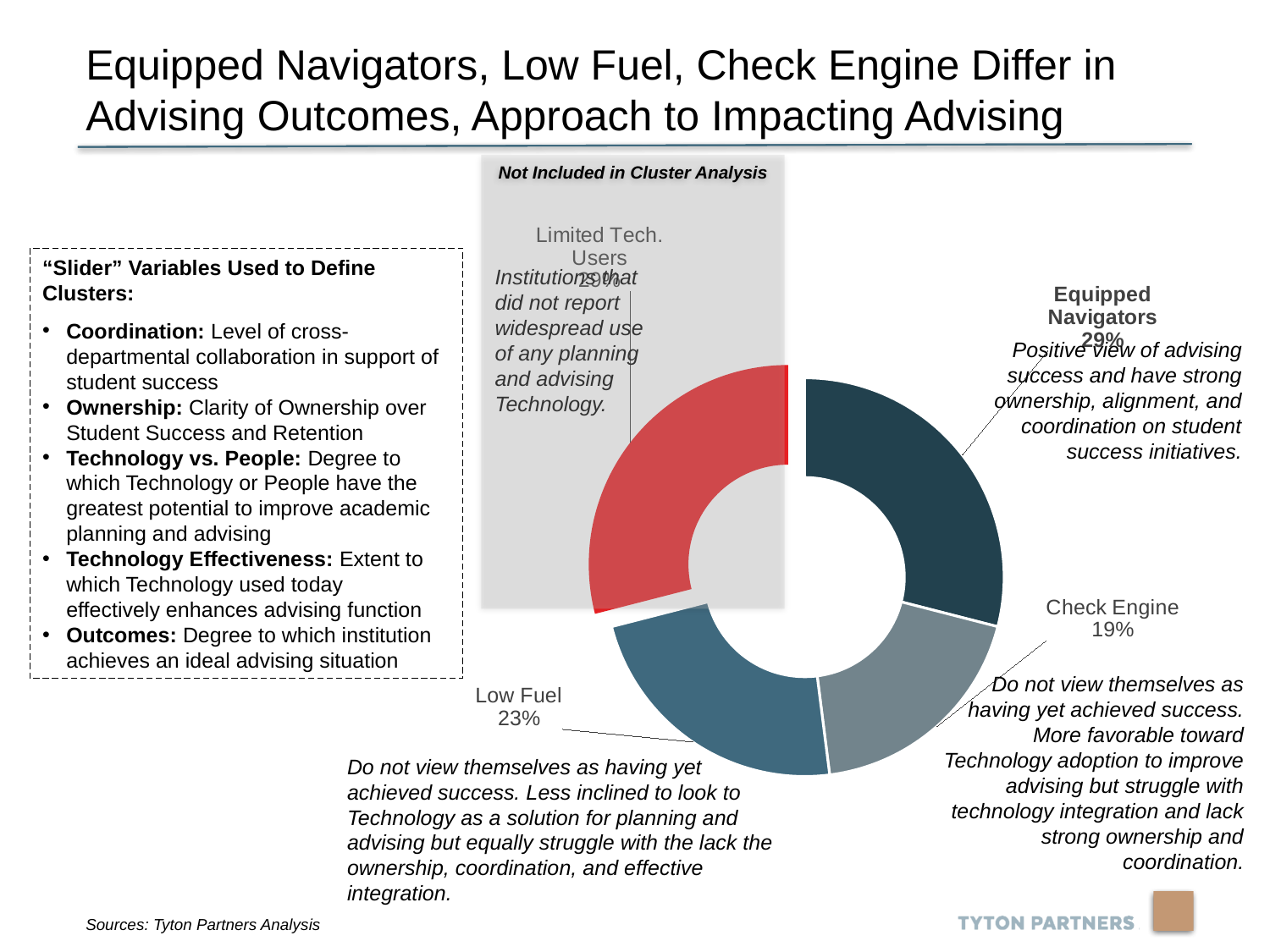
Which segment of the pie chart is marked as 'Not Included in Cluster Analysis'? Limited Tech. Users What percentage of the pie chart is labelled Low Fuel? 23% What percentage of the pie chart is labelled Check Engine? 19% What colour is the Equipped Navigators segment of the pie chart? Dark blue Which segment of the pie chart has the smallest share? Check Engine Which is larger in the pie chart, Low Fuel or Check Engine? Low Fuel What percentage of the pie chart is labelled Limited Tech. Users? 29% What percentage of the pie chart is labelled Equipped Navigators? 29% What share of the pie does the Check Engine segment represent? 19% How many segments does the pie chart have? 4 What is the difference in percentage points between Low Fuel and Check Engine? 4 percentage points What kind of chart is shown on the slide? Pie (donut) chart